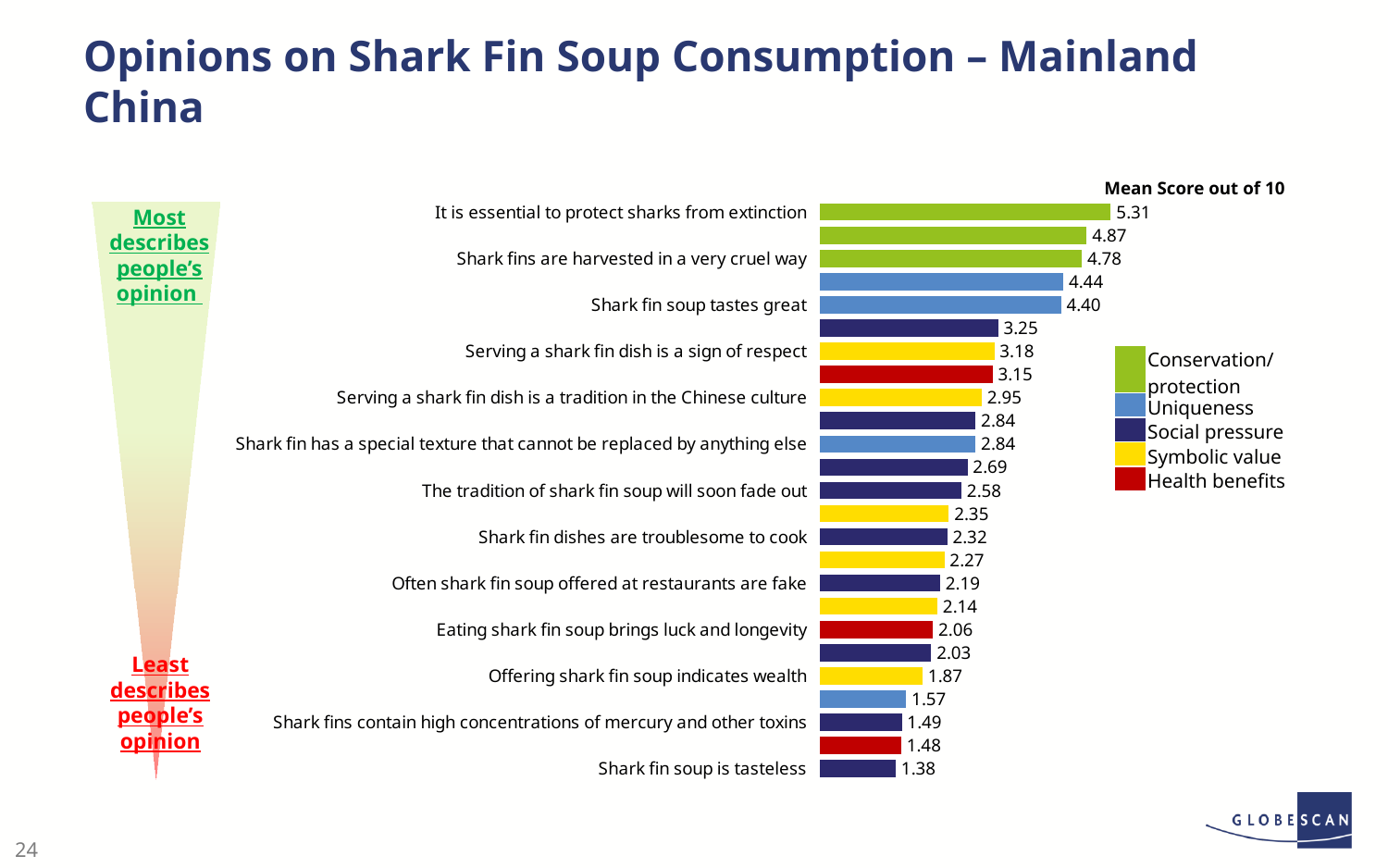
Which statement has the highest mean score? It is essential to protect sharks from extinction What is the mean score for "Shark fin soup tastes great"? 4.40 What is the difference between the mean scores for "Shark fins are harvested in a very cruel way" and "Shark fin soup tastes great"? 0.38 What is the difference between the mean scores for "Eating shark fin soup brings luck and longevity" and "Shark fin soup is tasteless"? 0.68 How many series does the legend list? 5 Which legend category is shown in red? Health benefits What is the mean score for "Serving a shark fin dish is a sign of respect"? 3.18 What is the mean score for "Shark fin soup is tasteless"? 1.38 Which has a higher mean score: "Shark fin dishes are troublesome to cook" or "Offering shark fin soup indicates wealth"? Shark fin dishes are troublesome to cook Which statement has the lowest mean score? Shark fin soup is tasteless What kind of chart is shown on the slide? Bar chart What is the mean score for "It is essential to protect sharks from extinction"? 5.31